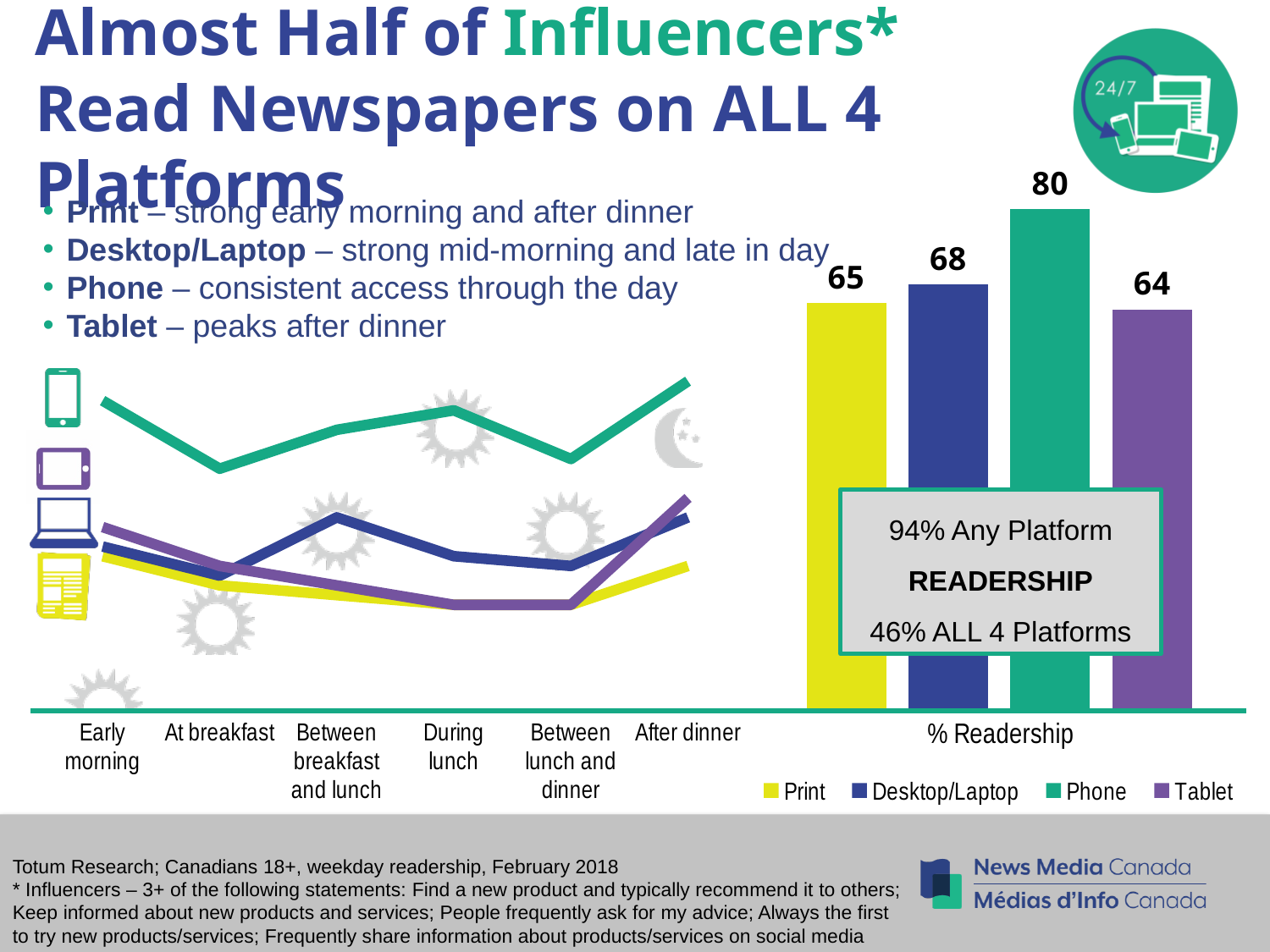
In the % Readership bar chart, what is the value for Phone? 80 In the line chart on the left, does the Phone line rise or fall from Between lunch and dinner to After dinner? Rise What kind of chart is the chart on the left of the slide showing readership by time of day? Line chart How many series does the legend list for the charts on the slide? 4 In the % Readership bar chart, what is the difference between the Phone and Print values? 15 In the % Readership bar chart, which is larger, Desktop/Laptop or Tablet? Desktop/Laptop In the % Readership bar chart, what is the value for Print? 65 In the % Readership bar chart, which platform has the lowest readership? Tablet In the % Readership bar chart, what is the value for Desktop/Laptop? 68 How many bars are in the % Readership bar chart? 4 In the % Readership bar chart, which platform has the highest readership? Phone How many time-of-day categories are on the x axis of the line chart on the left? 6